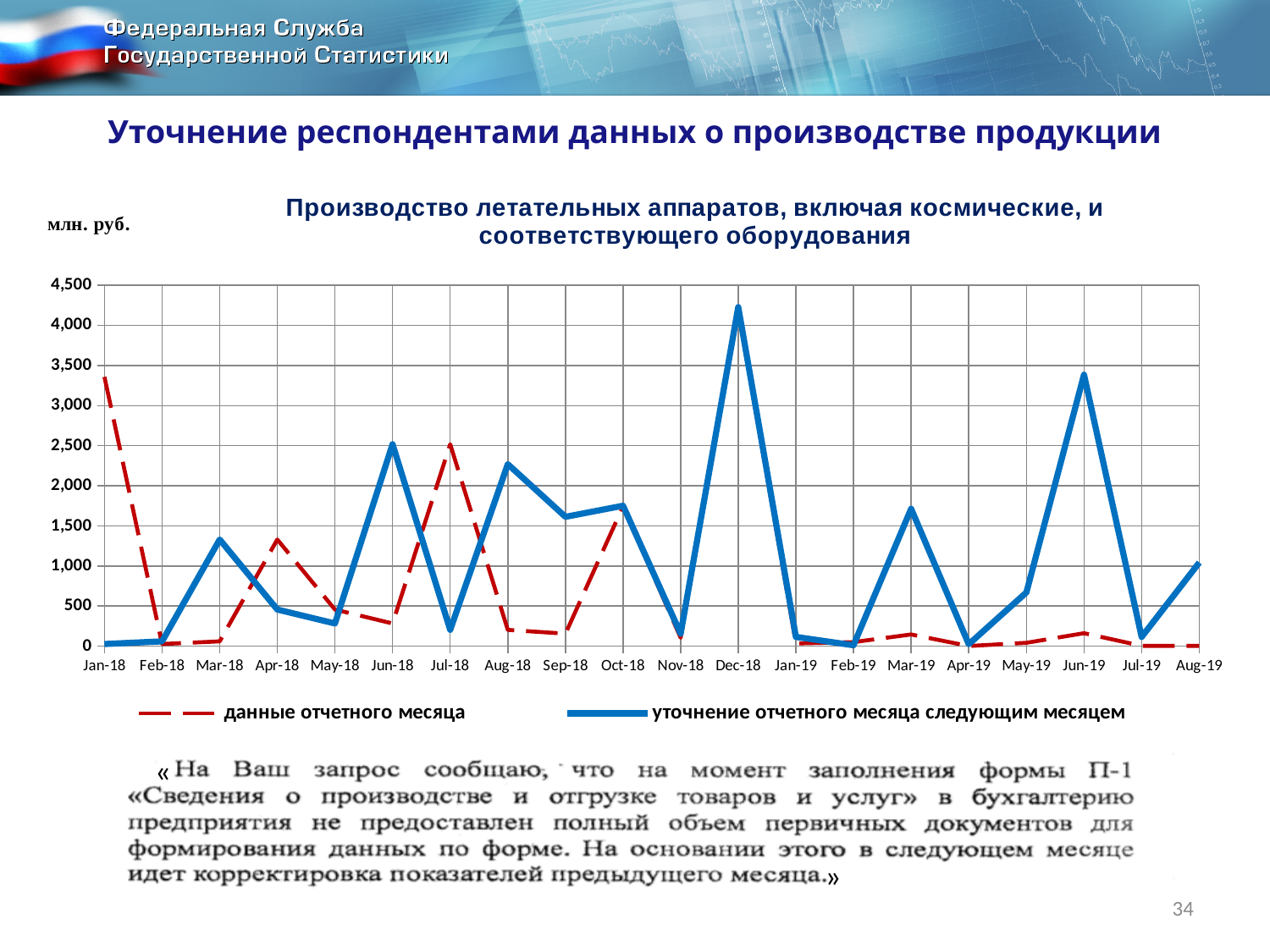
Is the value for Dec-18 in the series 'уточнение отчетного месяца следующим месяцем' greater or less than 4,000? greater Is the value for Apr-19 in the series 'уточнение отчетного месяца следующим месяцем' greater or less than 500? less Is the value for Jun-19 in the series 'уточнение отчетного месяца следующим месяцем' greater or less than 3,000? greater How many months are plotted along the x axis? 20 Does the series 'уточнение отчетного месяца следующим месяцем' rise or fall from Dec-18 to Feb-19? fall How many series does the legend list? 2 What unit is shown for the y axis of the chart? млн. руб. In which month does the series 'уточнение отчетного месяца следующим месяцем' reach its highest value? Dec-18 What kind of chart is shown on the slide? line chart